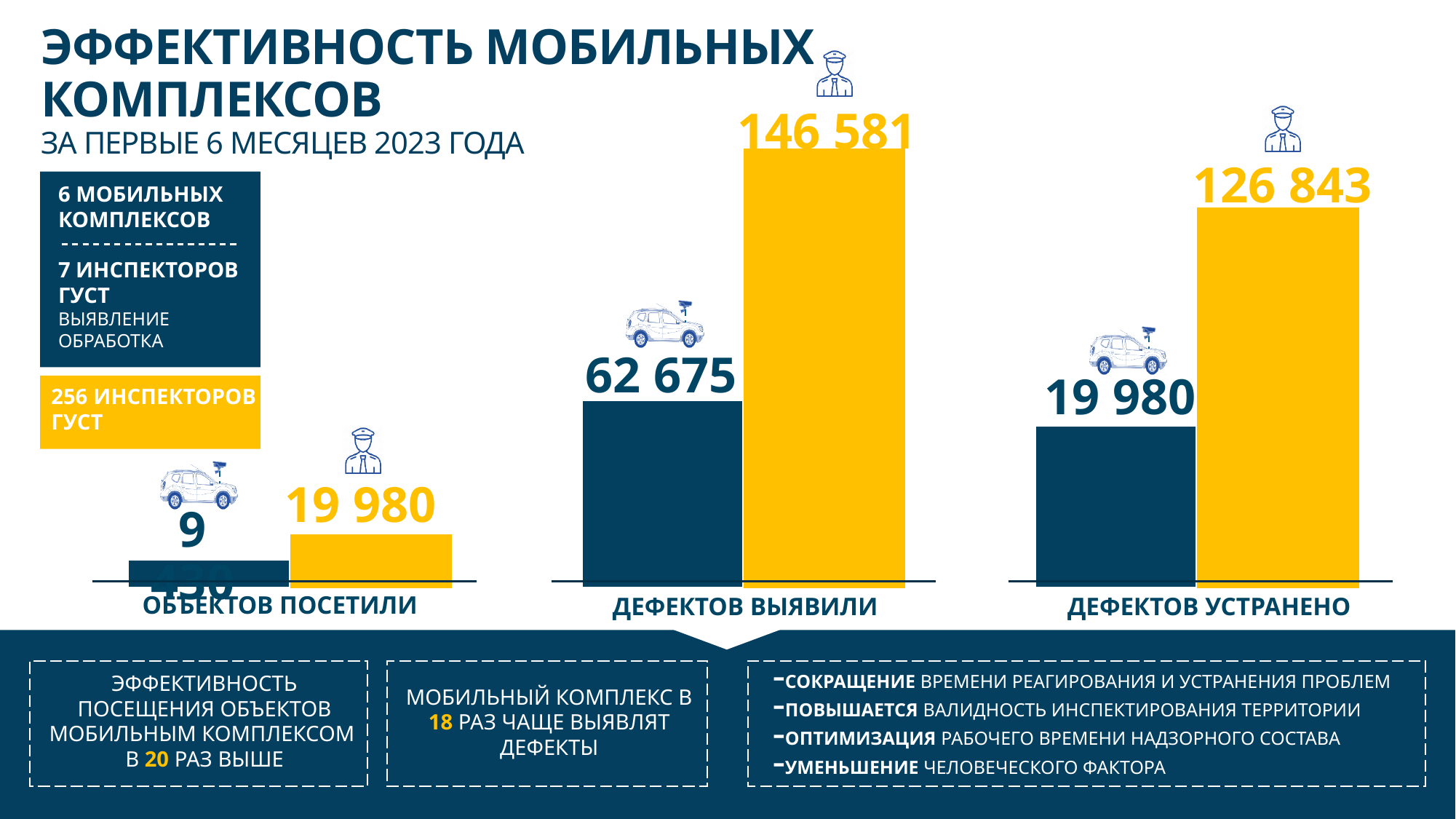
What value is shown for the dark blue bar (мобильные комплексы) in the ДЕФЕКТОВ ВЫЯВИЛИ group? 62 675 What is the difference between the yellow and dark blue bars in the ДЕФЕКТОВ ВЫЯВИЛИ group? 83 906 How many category groups are shown on the chart? 3 What value is shown for the dark blue bar in the ДЕФЕКТОВ УСТРАНЕНО group? 19 980 What value is shown for the yellow bar (256 инспекторов ГУСТ) in the ДЕФЕКТОВ ВЫЯВИЛИ group? 146 581 Which labelled value on the chart is the highest? 146 581 What colour represents 256 инспекторов ГУСТ on the chart? yellow In the ДЕФЕКТОВ ВЫЯВИЛИ group, which bar is larger: the dark blue (мобильные комплексы) or the yellow (256 инспекторов ГУСТ)? yellow (256 инспекторов ГУСТ) What kind of chart is shown on the slide? bar chart What value is shown for the yellow bar in the ОБЪЕКТОВ ПОСЕТИЛИ group? 19 980 What value is shown for the yellow bar in the ДЕФЕКТОВ УСТРАНЕНО group? 126 843 What is the difference between the yellow and dark blue bars in the ДЕФЕКТОВ УСТРАНЕНО group? 106 863